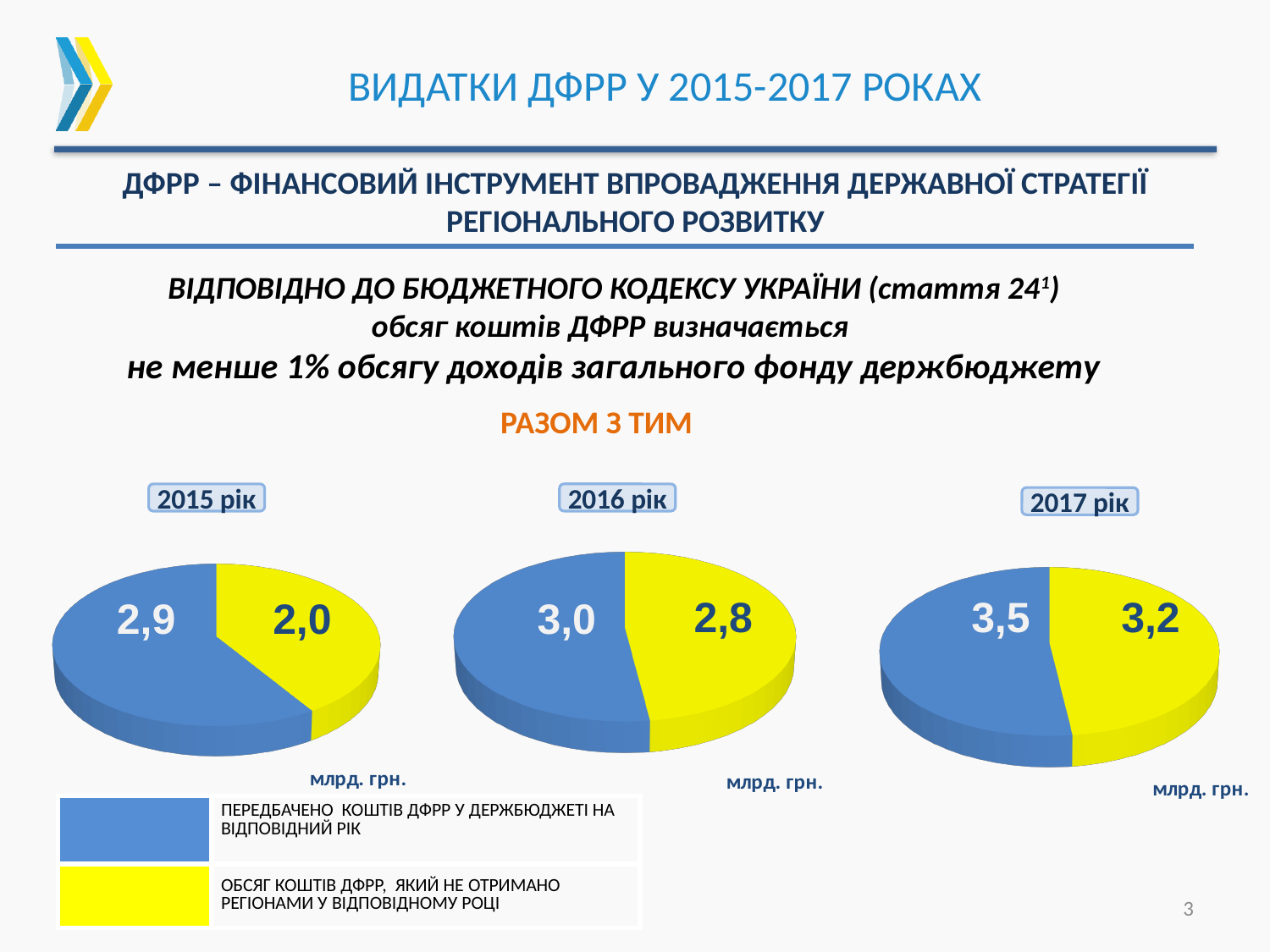
What type of chart is used for the 2015, 2016 and 2017 data on the slide? pie chart In the 2015 рік pie chart, what value is shown for the blue slice (ПЕРЕДБАЧЕНО КОШТІВ ДФРР У ДЕРЖБЮДЖЕТІ)? 2,9 Do the blue-slice values rise or fall from the 2015 рік chart to the 2017 рік chart? rise In the 2017 рік pie chart, what value is shown for the yellow slice? 3,2 In the 2017 рік pie chart, what value is shown for the blue slice? 3,5 Across the three pie charts, which chart has the highest blue-slice value? 2017 рік (3,5) What unit is shown under each of the three pie charts? млрд. грн. In the 2016 рік pie chart, what value is shown for the yellow slice? 2,8 In the 2016 рік pie chart, which slice is larger, the blue one or the yellow one? the blue one (3,0) In the 2015 рік pie chart, what is the difference between the blue slice and the yellow slice? 0,9 In the 2015 рік pie chart, what value is shown for the yellow slice (ОБСЯГ КОШТІВ ДФРР, ЯКИЙ НЕ ОТРИМАНО РЕГІОНАМИ)? 2,0 How many slices does each pie chart on the slide have? 2